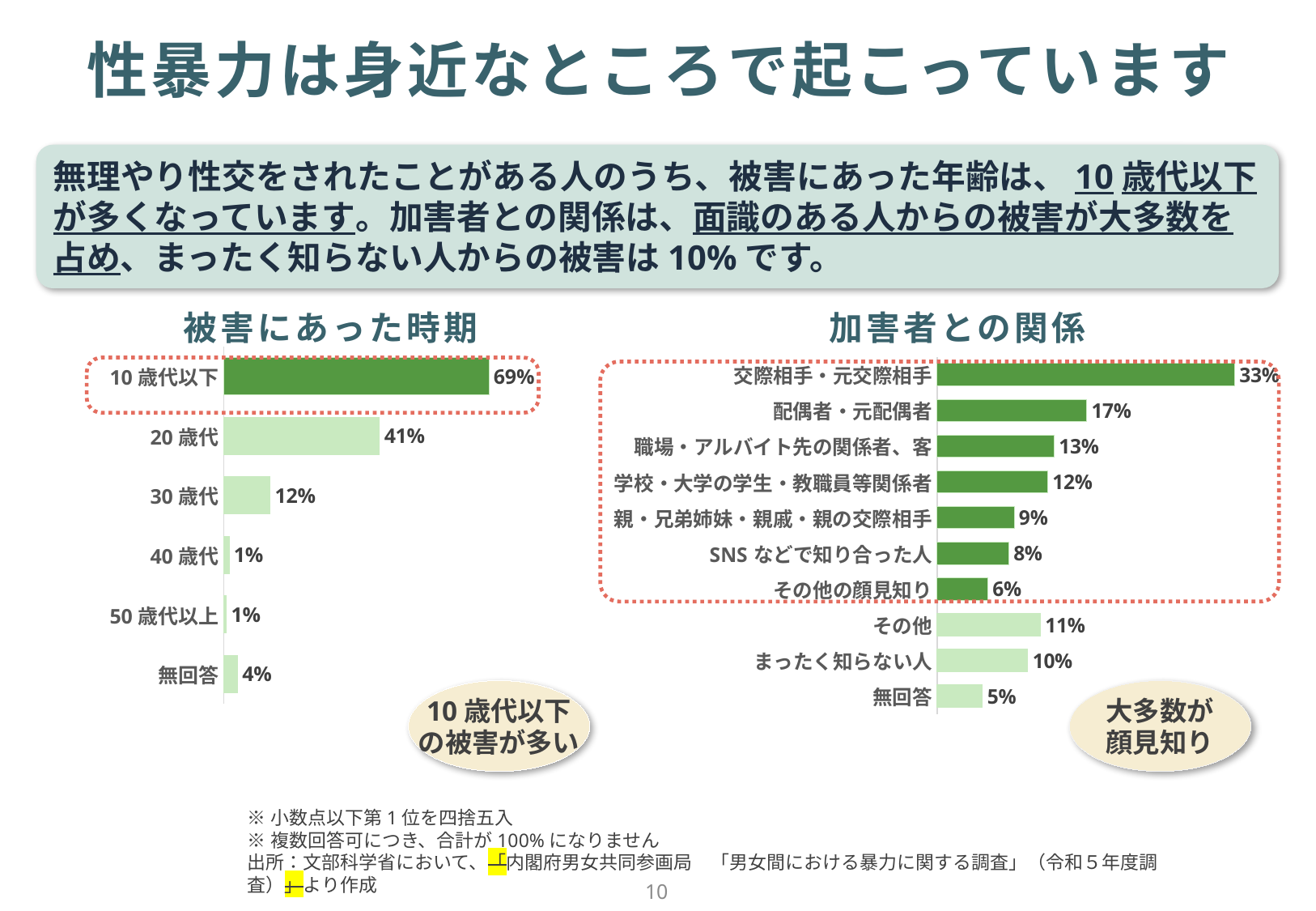
In the 被害にあった時期 chart, what is the difference between 10歳代以下 and 20歳代? 28% In the 加害者との関係 chart, which category has the lowest value? 無回答 What kind of chart is the 加害者との関係 chart? Bar chart In the 被害にあった時期 chart, which category has the highest value? 10歳代以下 In the 被害にあった時期 chart, how many categories are shown? 6 In the 加害者との関係 chart, how many categories are shown? 10 In the 被害にあった時期 chart, what is the value for 30歳代? 12% In the 加害者との関係 chart, which is larger: SNSなどで知り合った人 or その他の顔見知り? SNSなどで知り合った人 In the 加害者との関係 chart, what is the value for 配偶者・元配偶者? 17% In the 被害にあった時期 chart, what is the value for 10歳代以下? 69% In the 加害者との関係 chart, which category has the highest value? 交際相手・元交際相手 In the 加害者との関係 chart, what is the value for まったく知らない人? 10%